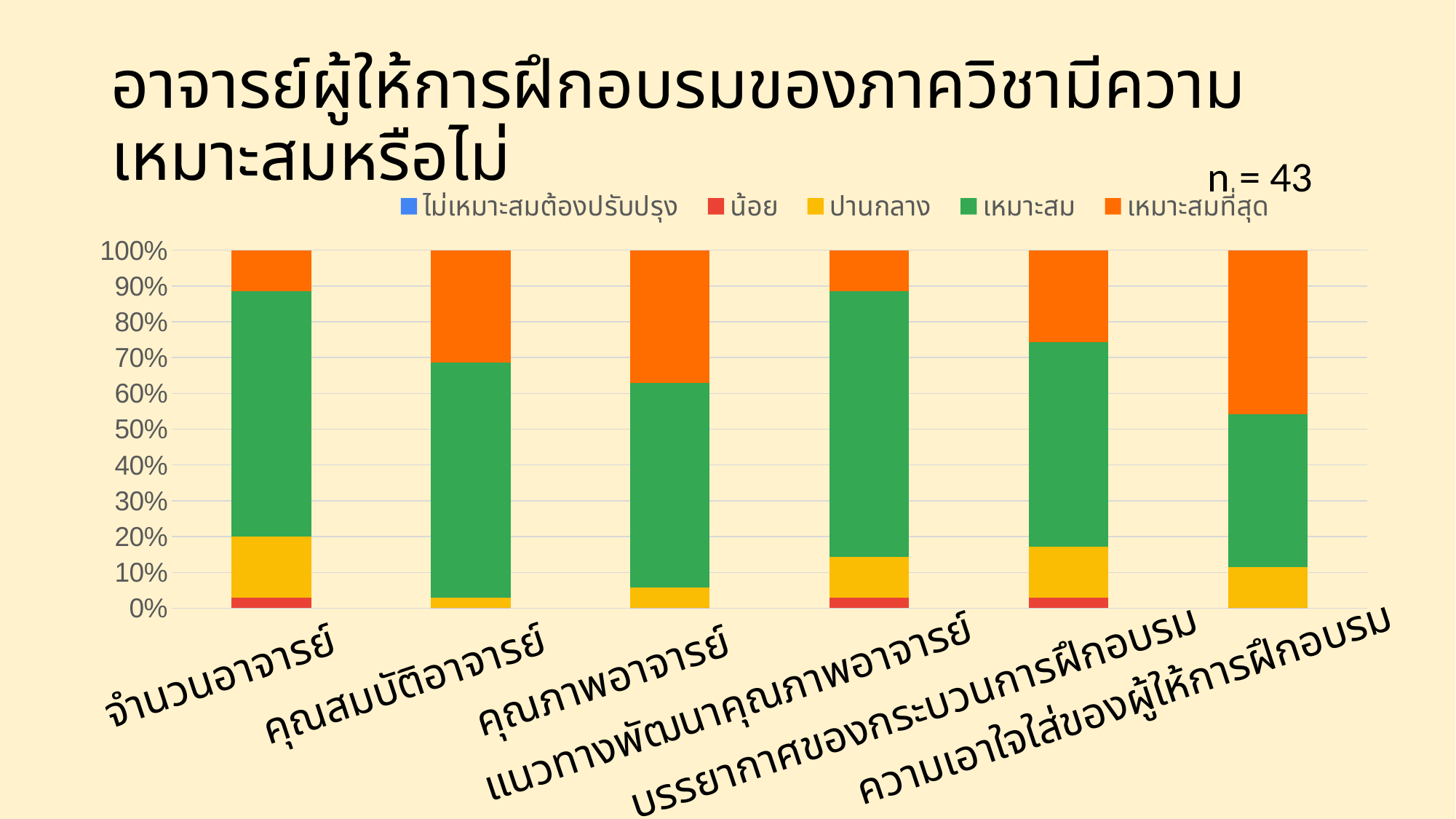
Which has the larger เหมาะสมที่สุด segment, คุณสมบัติอาจารย์ or จำนวนอาจารย์? คุณสมบัติอาจารย์ How many categories are shown along the x axis? 6 Which category has the smallest เหมาะสม segment? ความเอาใจใส่ของผู้ให้การฝึกอบรม Is the ปานกลาง segment for คุณสมบัติอาจารย์ greater or less than 10%? less How many series does the legend list? 5 What sample size (n) is shown on the slide? n = 43 What kind of chart is shown on the slide? stacked bar chart Which category has the largest เหมาะสมที่สุด segment? ความเอาใจใส่ของผู้ให้การฝึกอบรม Is the เหมาะสมที่สุด segment for จำนวนอาจารย์ greater or less than 20%? less Is the เหมาะสม segment for จำนวนอาจารย์ greater or less than 60%? greater Which legend entry is shown in orange? เหมาะสมที่สุด